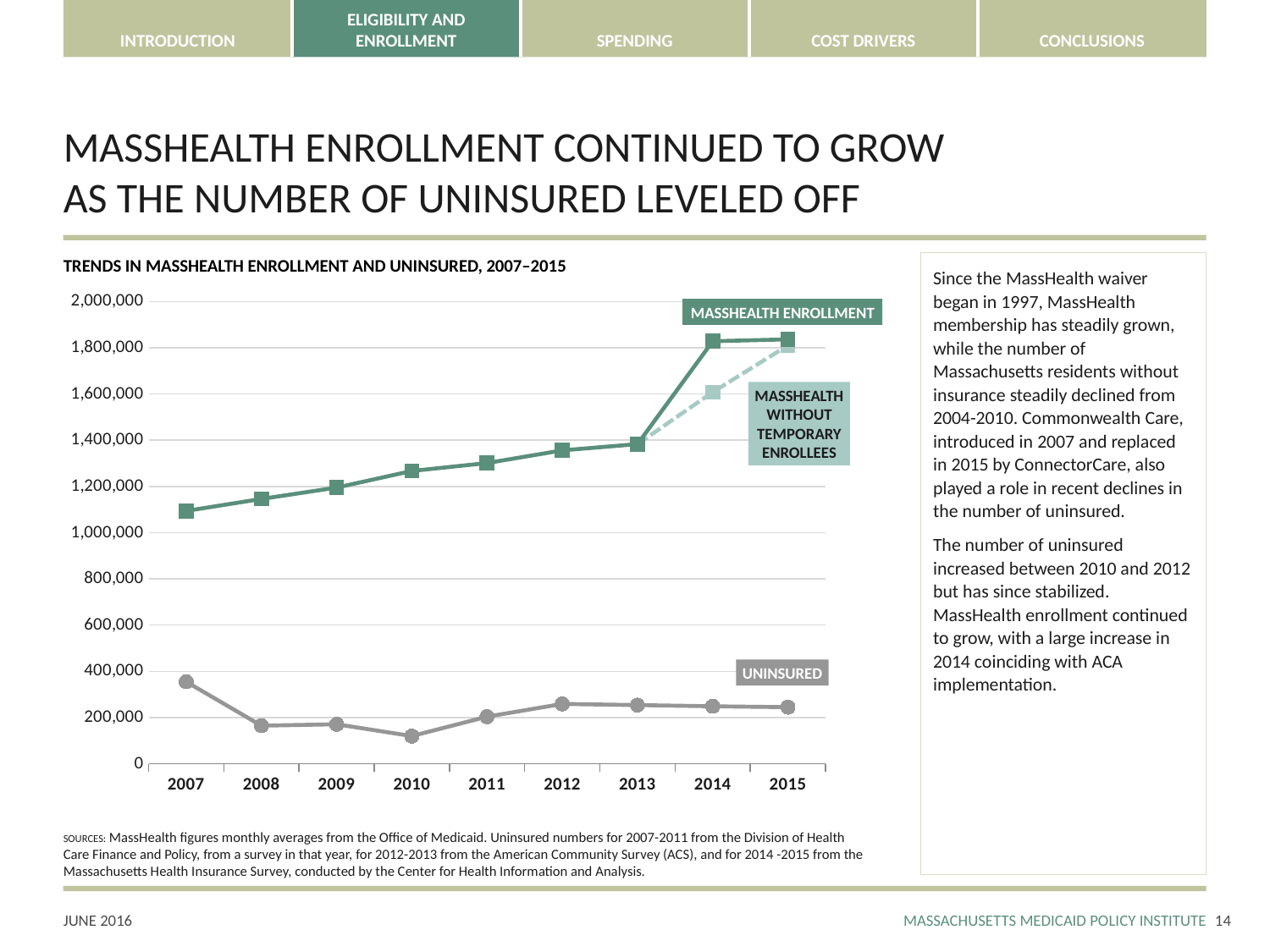
What is the title of the chart? TRENDS IN MASSHEALTH ENROLLMENT AND UNINSURED, 2007–2015 Which is larger, the Uninsured value for 2007 or the Uninsured value for 2008? 2007 Is the MassHealth Enrollment value for 2007 greater or less than 1,000,000? greater In which year is the Uninsured series at its lowest? 2010 In which year is the MassHealth Enrollment series at its lowest? 2007 In which year is the Uninsured series at its highest? 2007 How many years are plotted along the x axis of the chart? 9 How many data series are labeled on the chart? 3 Is the Uninsured value for 2010 greater or less than 200,000? less Does the MassHealth Enrollment series generally rise or fall from 2007 to 2015? Rise What kind of chart is shown on the slide? Line chart